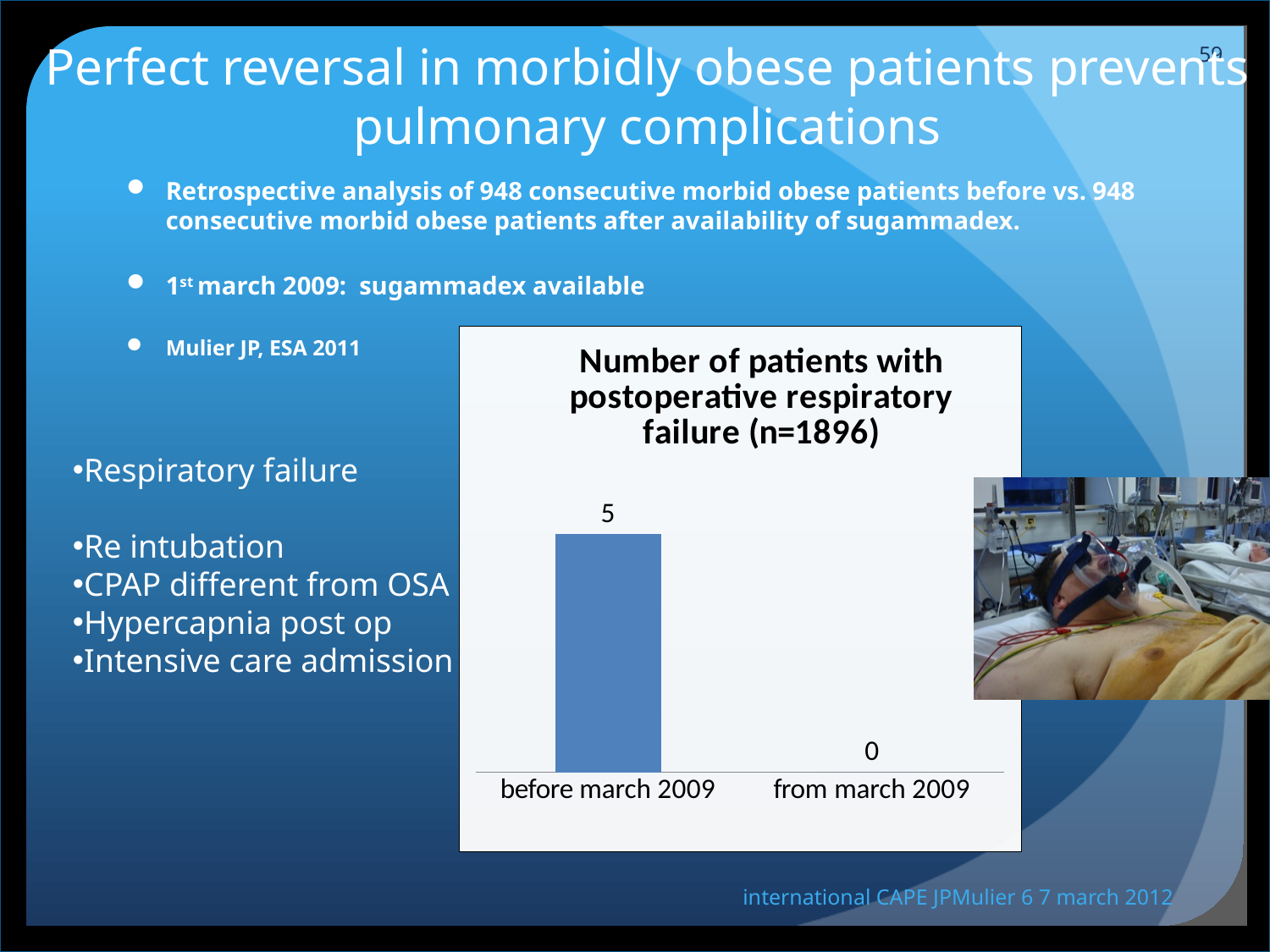
What is the number of patients with postoperative respiratory failure from march 2009? 0 Which category has the lowest number of patients with postoperative respiratory failure? from march 2009 What is the total number of patients (n) stated in the chart title? 1896 What is the difference between the number of patients with respiratory failure before march 2009 and from march 2009? 5 Is the value for before march 2009 larger or smaller than the value for from march 2009? larger How many categories are shown on the x axis of the chart? 2 Which category has the higher number of patients with postoperative respiratory failure? before march 2009 What kind of chart is shown on the slide? bar chart What is the number of patients with postoperative respiratory failure before march 2009? 5 Do the values rise or fall from left to right along the x axis? fall What is the title of the chart? Number of patients with postoperative respiratory failure (n=1896)